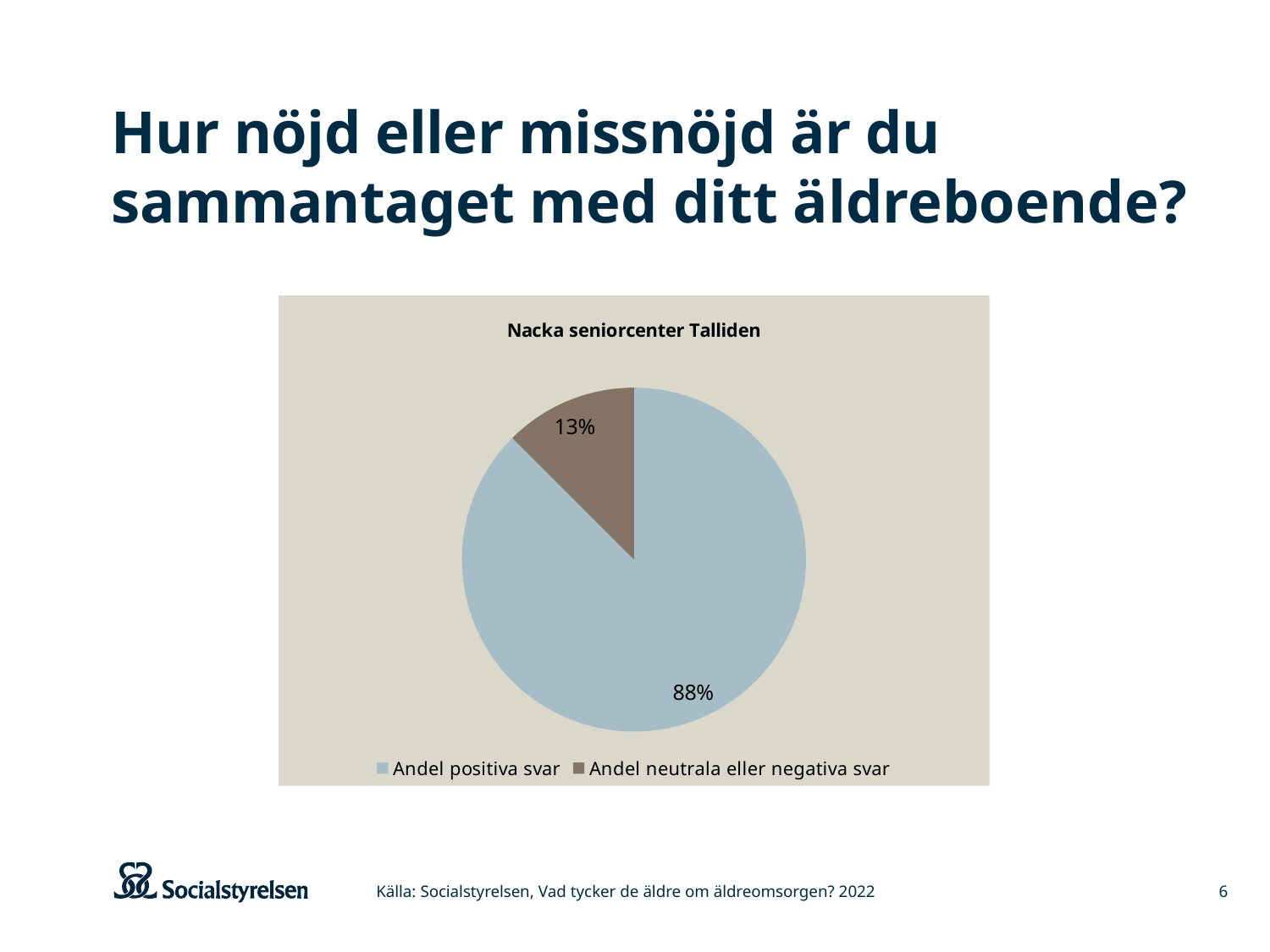
How many entries does the legend list? 2 How many slices does the pie chart have? 2 Which slice is the largest? Andel positiva svar What is the title of the chart? Nacka seniorcenter Talliden What colour is the slice for Andel positiva svar? light blue What is the value for Andel neutrala eller negativa svar? 13% Which is larger, Andel positiva svar or Andel neutrala eller negativa svar? Andel positiva svar What type of chart is shown on the slide? pie chart Which slice is the smallest? Andel neutrala eller negativa svar What is the value for Andel positiva svar? 88% What is the difference between Andel positiva svar and Andel neutrala eller negativa svar? 75 percentage points What share of the pie does Andel neutrala eller negativa svar represent? 13%